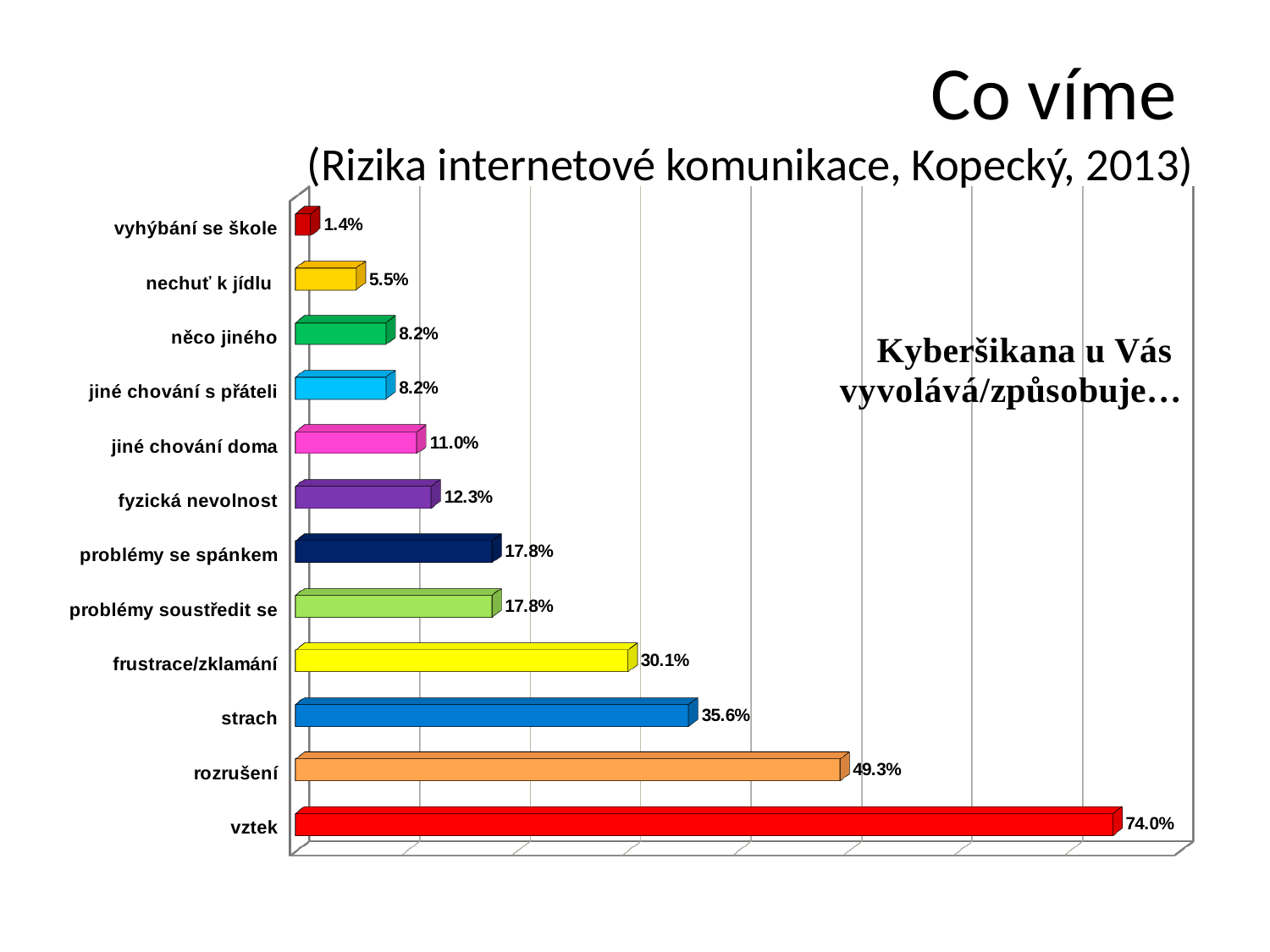
What is the difference between the values for "vztek" and "frustrace/zklamání"? 43.9% What is the value for "fyzická nevolnost"? 12.3% How many categories are shown in the chart? 12 Which category has the lowest value? vyhýbání se škole What is the value for "strach"? 35.6% What is the value for "nechuť k jídlu"? 5.5% What is the title text shown inside the chart area? Kyberšikana u Vás vyvolává/způsobuje… What is the value for "vztek"? 74.0% Which category has the highest value? vztek Which is larger, the value for "jiné chování doma" or the value for "něco jiného"? jiné chování doma What is the difference between the values for "rozrušení" and "strach"? 13.7% What kind of chart is shown on the slide? bar chart